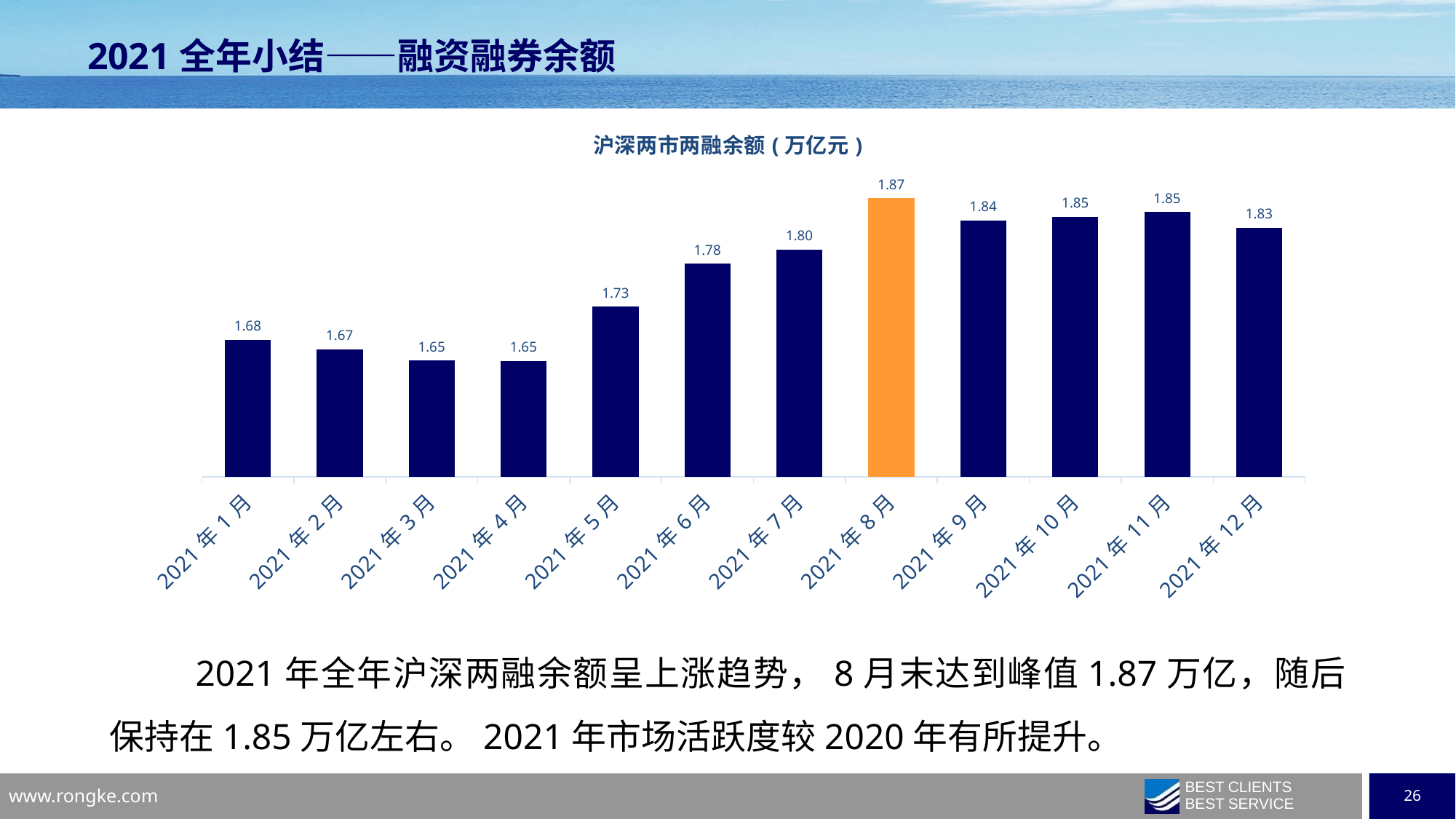
Which month has the highest value? 2021年8月 What is the value for 2021年12月? 1.83 How many months are shown on the chart? 12 Do the values rise or fall from 2021年4月 to 2021年8月? Rise What is the difference between the values for 2021年7月 and 2021年6月? 0.02 Which is larger, the value for 2021年6月 or the value for 2021年5月? 2021年6月 What is the value for 2021年1月? 1.68 What kind of chart is this? Bar chart What is the title of the chart? 沪深两市两融余额（万亿元） What is the difference between the values for 2021年8月 and 2021年1月? 0.19 What is the value for 2021年8月? 1.87 Which bar is coloured orange instead of dark blue? 2021年8月